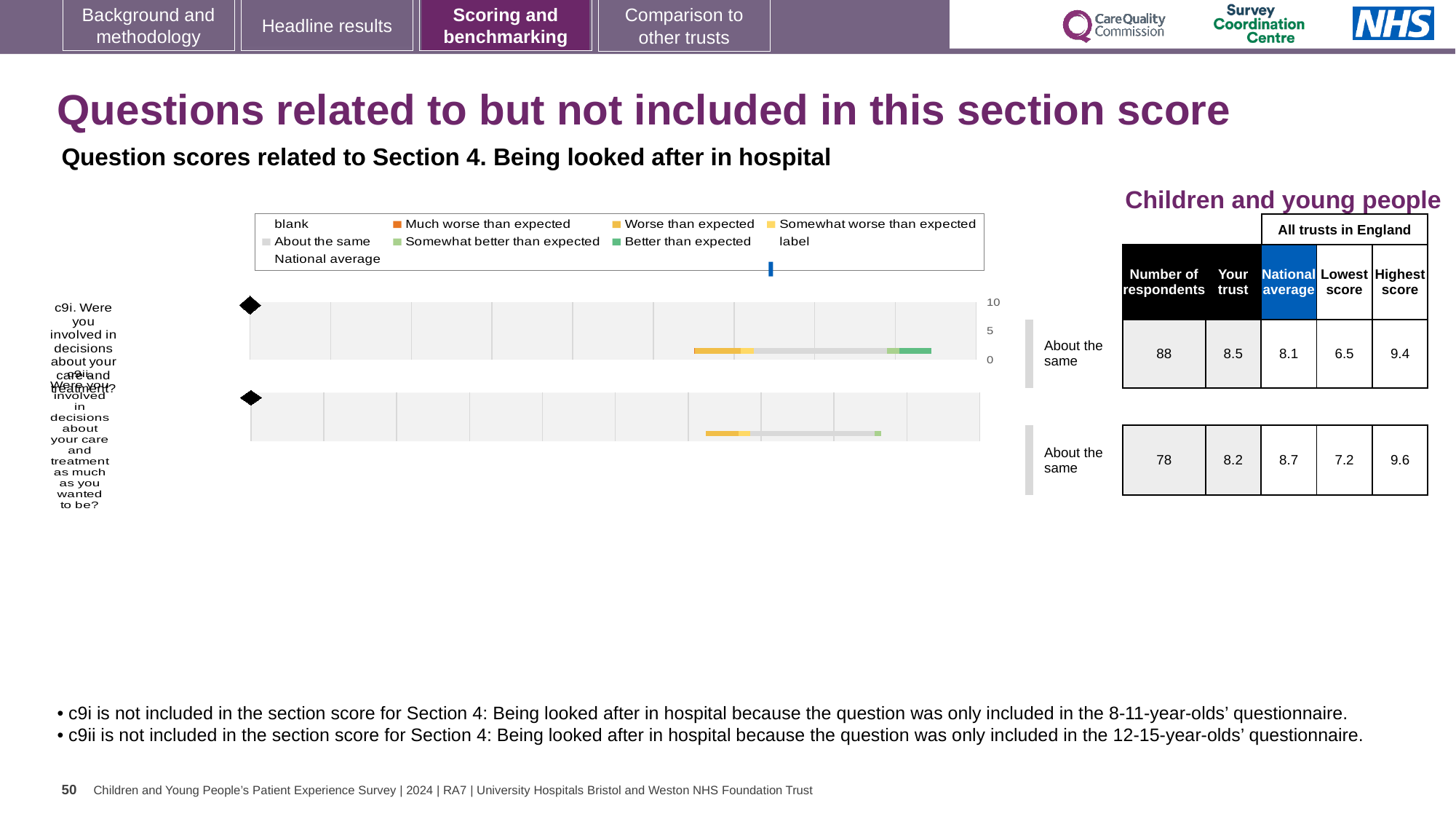
How many questions (bars) are plotted in the chart? 2 What benchmark category is shown for question c9ii? About the same What kind of chart is used to show the question scores for c9i and c9ii? bar chart What is the difference between the highest score and the lowest score across all trusts in England for question c9ii? 2.4 What is the 'Your trust' score for question c9ii? 8.2 What is the national average score for question c9ii? 8.7 Which question has the higher 'Your trust' score, c9i or c9ii? c9i How many entries does the chart legend list? 9 What is the 'Your trust' score for question c9i? 8.5 What is the difference between the 'Your trust' score and the national average for question c9i? 0.4 What is the national average score for question c9i? 8.1 What is the highest value shown on the chart's score axis? 10